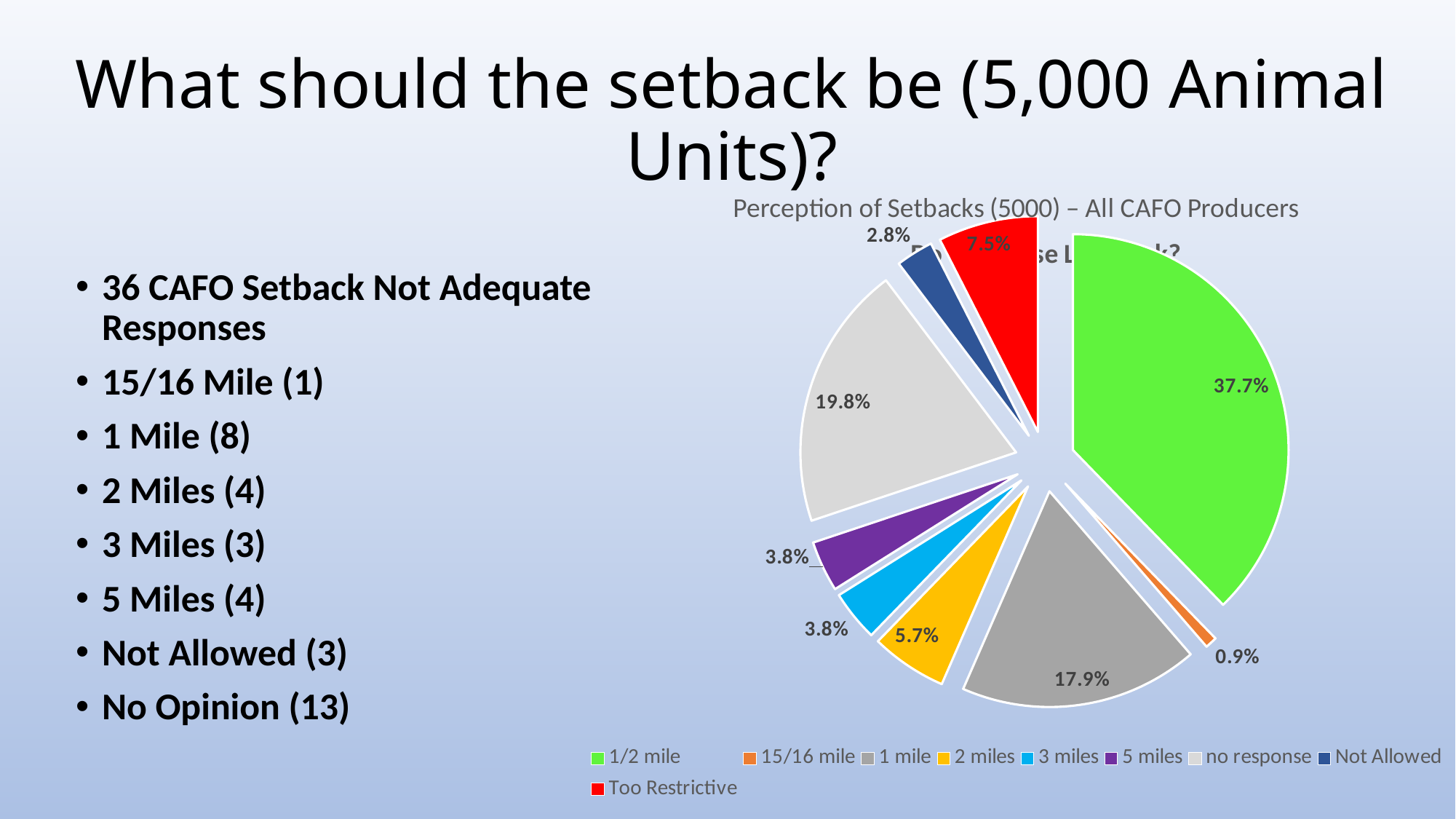
What kind of chart is shown on the slide? pie chart What percentage is shown for the no response slice? 19.8% What is the difference in percentage points between the 1/2 mile slice and the 1 mile slice? 19.8 Which category has the smallest slice of the pie? 15/16 mile Which category has the largest slice of the pie? 1/2 mile What is the title of the chart? Perception of Setbacks (5000) – All CAFO Producers What percentage is shown for the Too Restrictive slice? 7.5% What percentage is shown for the Not Allowed slice? 2.8% How many categories does the legend list? 9 What share of the pie does the 1/2 mile slice represent? 37.7% What percentage is shown for the 1 mile slice? 17.9% Which is larger, the no response slice or the 1 mile slice? no response